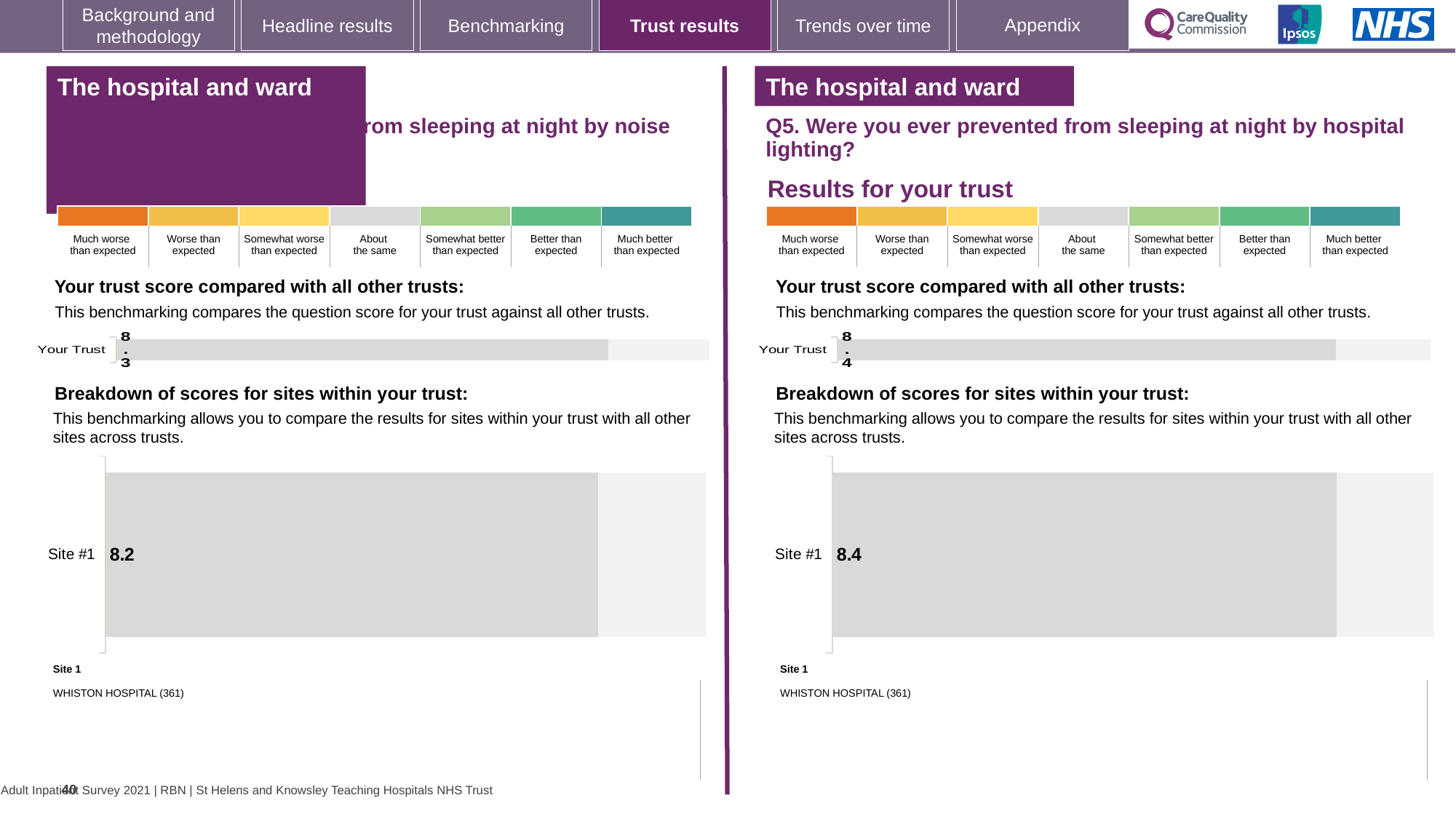
On the right half of the slide (Q5, hospital lighting), what is the score shown for Your Trust in the 'Your trust score compared with all other trusts' chart? 8.4 On the left half of the slide, what is the score shown for Site #1 in the 'Breakdown of scores for sites within your trust' chart? 8.2 Which is larger: the Your Trust score on the left half of the slide or the Your Trust score on the right half (Q5, hospital lighting)? The right half (Q5, hospital lighting) On the right half of the slide, is the Site #1 score equal to the Your Trust score? Yes On the right half of the slide (Q5, hospital lighting), what is the score shown for Site #1 in the 'Breakdown of scores for sites within your trust' chart? 8.4 How many sites are plotted in the 'Breakdown of scores for sites within your trust' chart on the left half of the slide? 1 On the left half of the slide, what is the score shown for Your Trust in the 'Your trust score compared with all other trusts' chart? 8.3 What kind of chart is used to show the Site #1 score on the right half of the slide? Bar chart Which hospital is listed as Site 1 beneath the site breakdown chart on the right half of the slide? WHISTON HOSPITAL (361) How many benchmark categories are shown in the colour key above the charts on the right half of the slide? 7 What is the difference between the Your Trust score on the right half of the slide (8.4) and the Your Trust score on the left half (8.3)? 0.1 What is the difference between the Site #1 score on the right half of the slide (8.4) and the Site #1 score on the left half (8.2)? 0.2